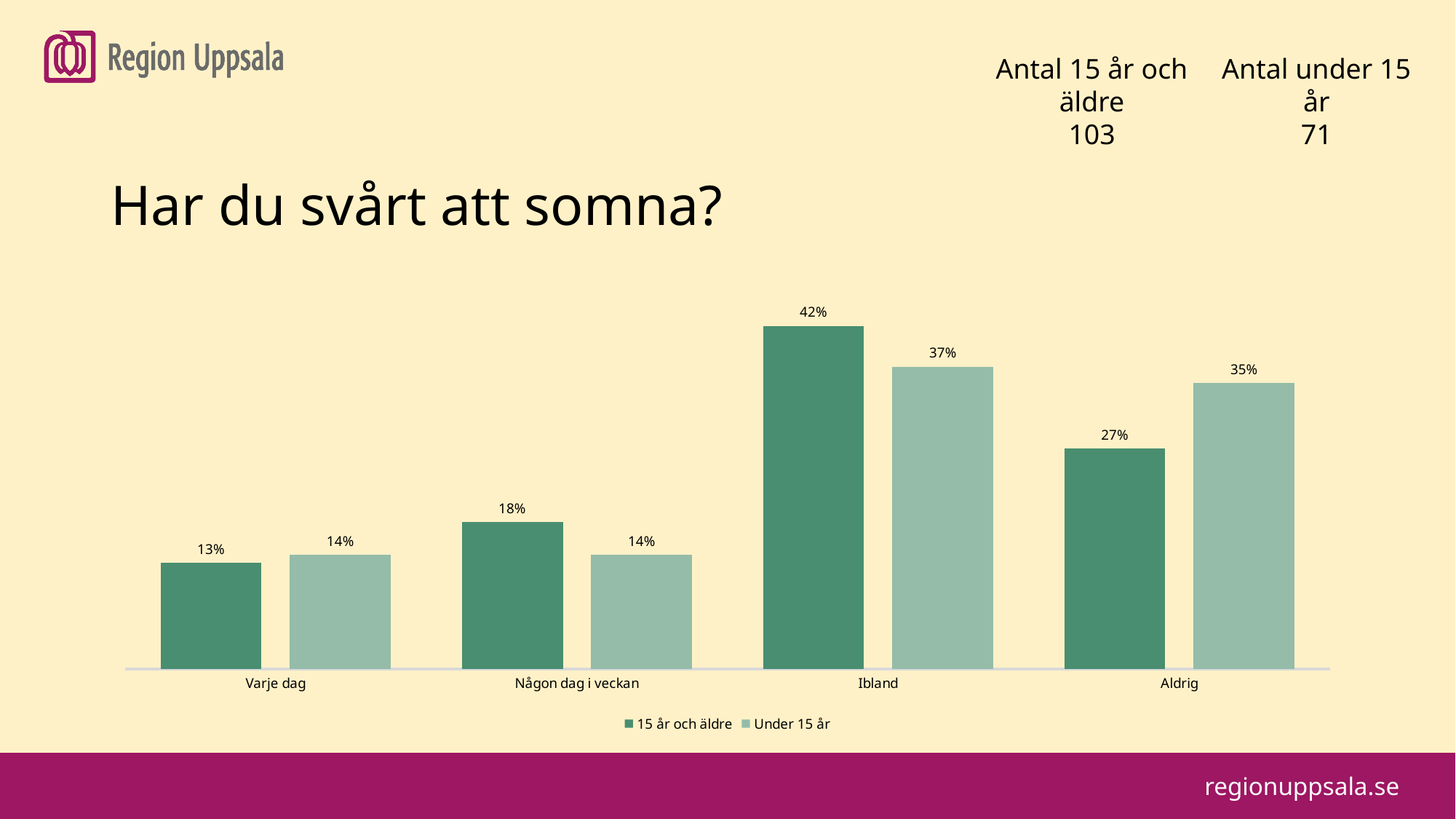
Which category has the highest value for the "15 år och äldre" series? Ibland How many categories are shown on the x axis? 4 What is the value for "15 år och äldre" in the "Ibland" category? 42% What is the title of the slide above the chart? Har du svårt att somna? In the "Ibland" category, which series has the larger value, "15 år och äldre" or "Under 15 år"? 15 år och äldre What is the difference between the "15 år och äldre" and "Under 15 år" values in the "Någon dag i veckan" category? 4% How many series does the legend list? 2 What is the value for "Under 15 år" in the "Aldrig" category? 35% What is the value for "15 år och äldre" in the "Varje dag" category? 13% What is the difference between the "15 år och äldre" and "Under 15 år" values in the "Aldrig" category? 8% What kind of chart is shown on the slide? Bar chart